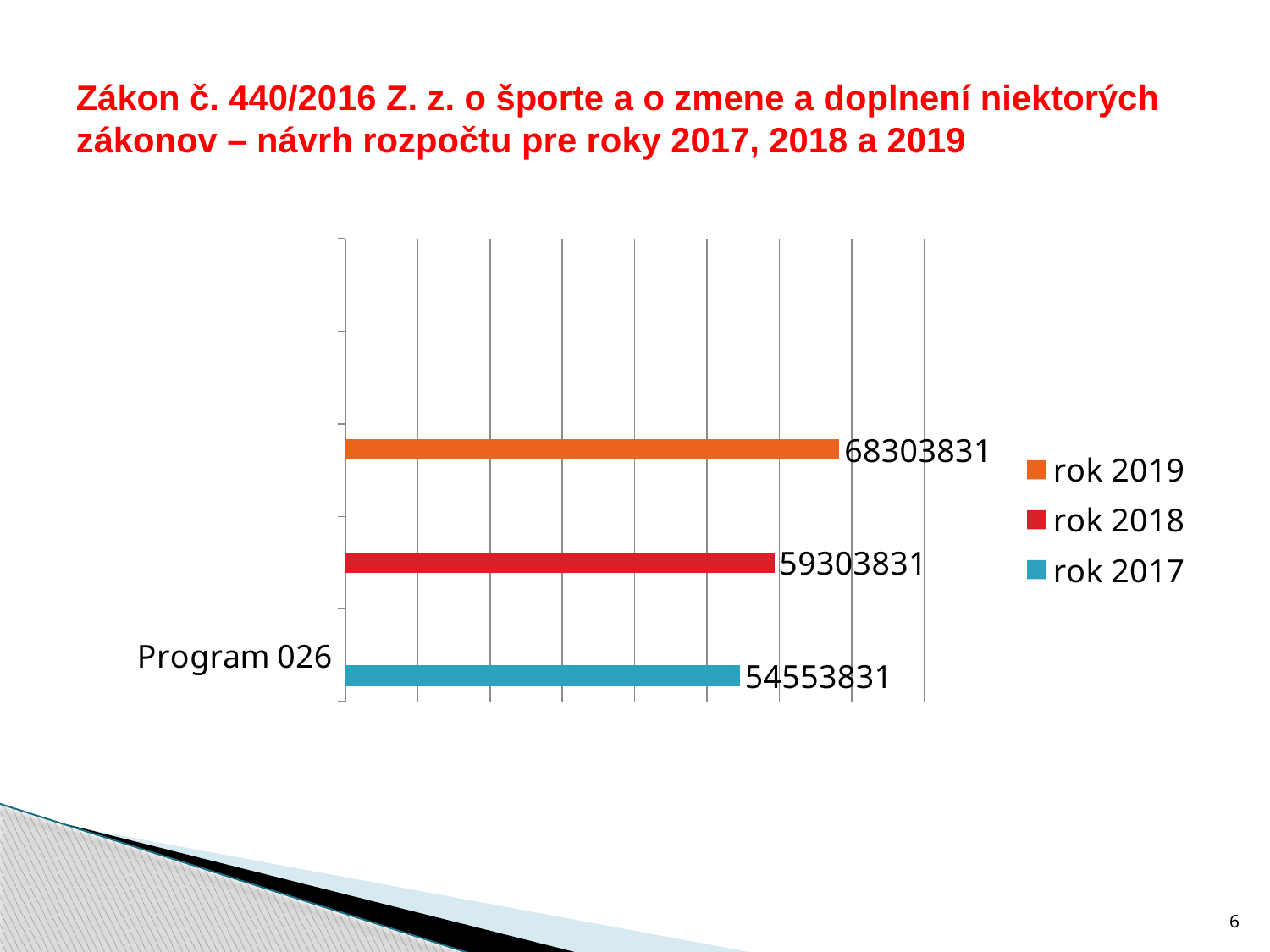
Which year has the lowest value for Program 026? rok 2017 What is the difference between the rok 2018 and rok 2017 values for Program 026? 4750000 What is the name of the category shown on the chart's vertical axis? Program 026 What is the difference between the rok 2019 and rok 2018 values for Program 026? 9000000 Which year has the highest value for Program 026? rok 2019 Which is larger for Program 026, the value for rok 2018 or rok 2017? rok 2018 What kind of chart is shown on the slide? bar chart What is the value for rok 2017 for Program 026? 54553831 What is the value for rok 2018 for Program 026? 59303831 How many series does the legend list? 3 What is the value for rok 2019 for Program 026? 68303831 What is the difference between the rok 2019 and rok 2017 values for Program 026? 13750000